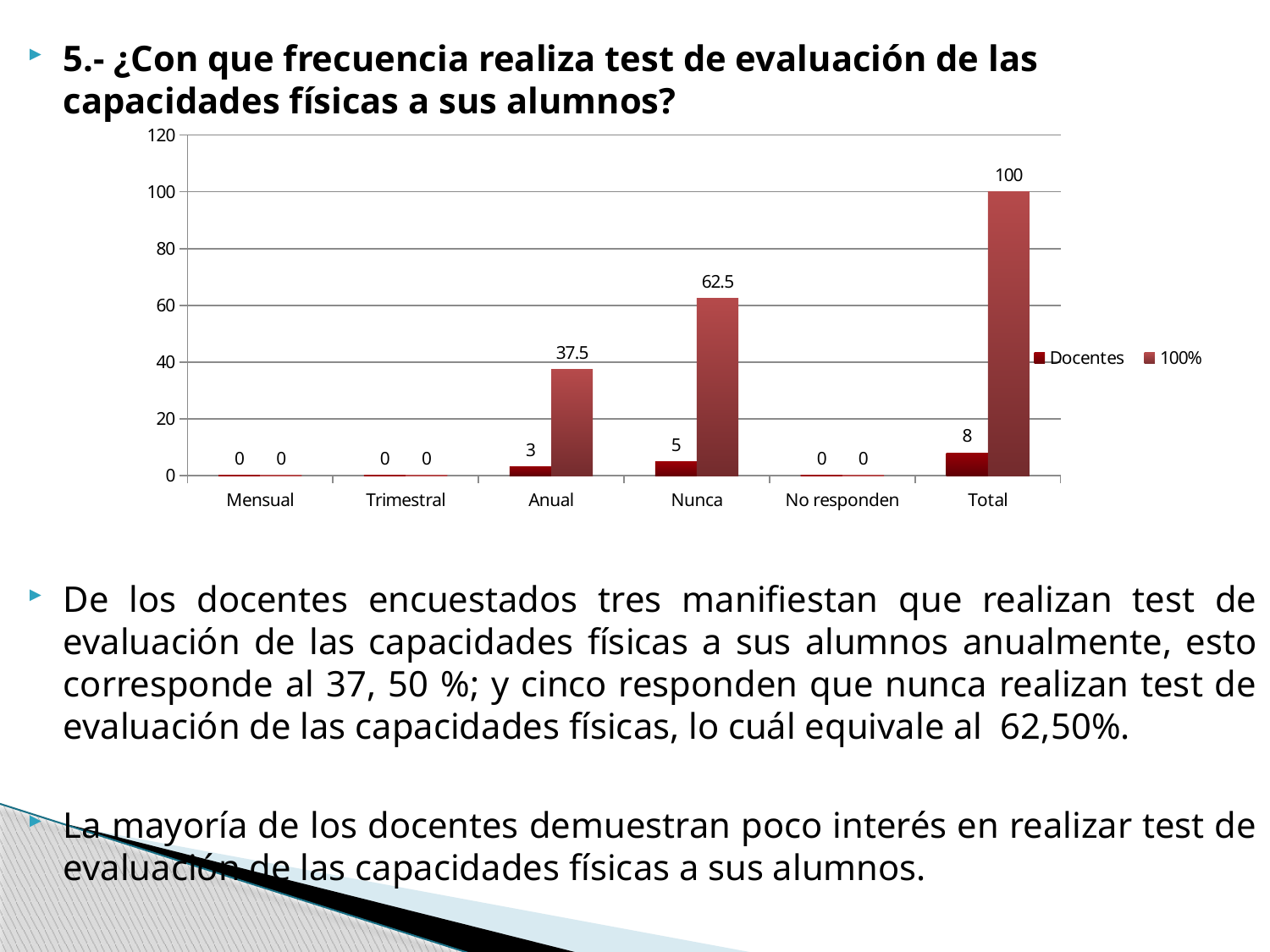
What is the 100% value for Nunca? 62.5 What is the difference between the 100% values for Nunca and Anual? 25 What is the Docentes value for Anual? 3 What kind of chart is shown on the slide? Bar chart How many series does the legend list? 2 Which category has the highest 100% value? Total What is the Docentes value for Total? 8 Which is larger, the Docentes value for Nunca or for Anual? Nunca How many categories are shown on the x axis? 6 Excluding Total, which category has the highest Docentes value? Nunca What is the 100% value for Anual? 37.5 What is the Docentes value for Mensual? 0